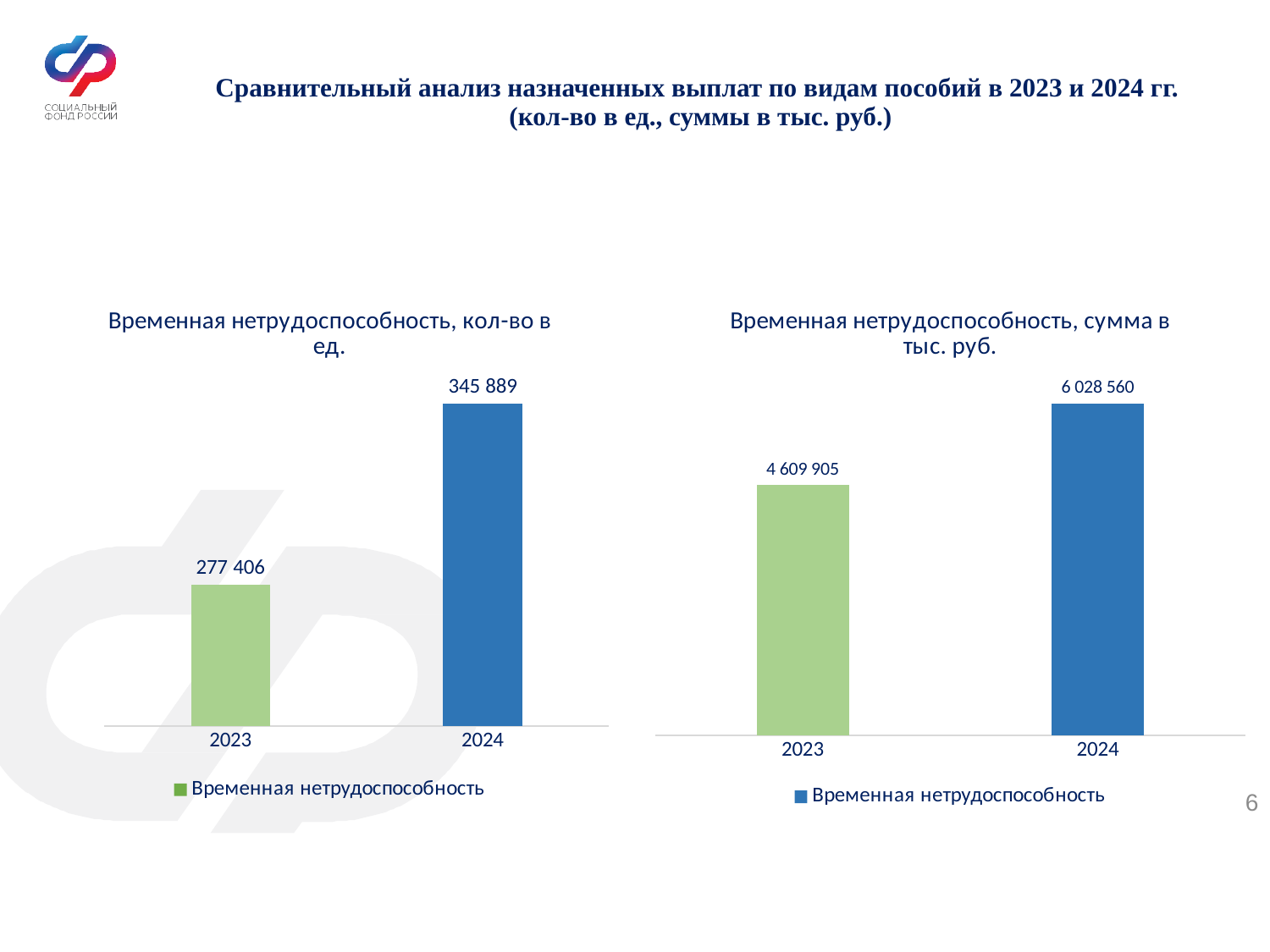
In the left chart (Временная нетрудоспособность, кол-во в ед.), what is the difference between the 2024 and 2023 values? 68 483 What type of chart is the right chart (Временная нетрудоспособность, сумма в тыс. руб.)? bar chart In the right chart (Временная нетрудоспособность, сумма в тыс. руб.), what is the value for 2024? 6 028 560 In the left chart (Временная нетрудоспособность, кол-во в ед.), which year has the higher value? 2024 In the right chart (Временная нетрудоспособность, сумма в тыс. руб.), is the value for 2023 larger or smaller than the value for 2024? smaller What is the legend entry shown under the left chart (Временная нетрудоспособность, кол-во в ед.)? Временная нетрудоспособность How many categories (years) are shown in the left chart (Временная нетрудоспособность, кол-во в ед.)? 2 In the right chart (Временная нетрудоспособность, сумма в тыс. руб.), which year has the lower value? 2023 In the left chart (Временная нетрудоспособность, кол-во в ед.), what is the value for 2023? 277 406 In the right chart (Временная нетрудоспособность, сумма в тыс. руб.), what is the value for 2023? 4 609 905 In the left chart (Временная нетрудоспособность, кол-во в ед.), what is the value for 2024? 345 889 In the right chart (Временная нетрудоспособность, сумма в тыс. руб.), what is the difference between the 2024 and 2023 values? 1 418 655